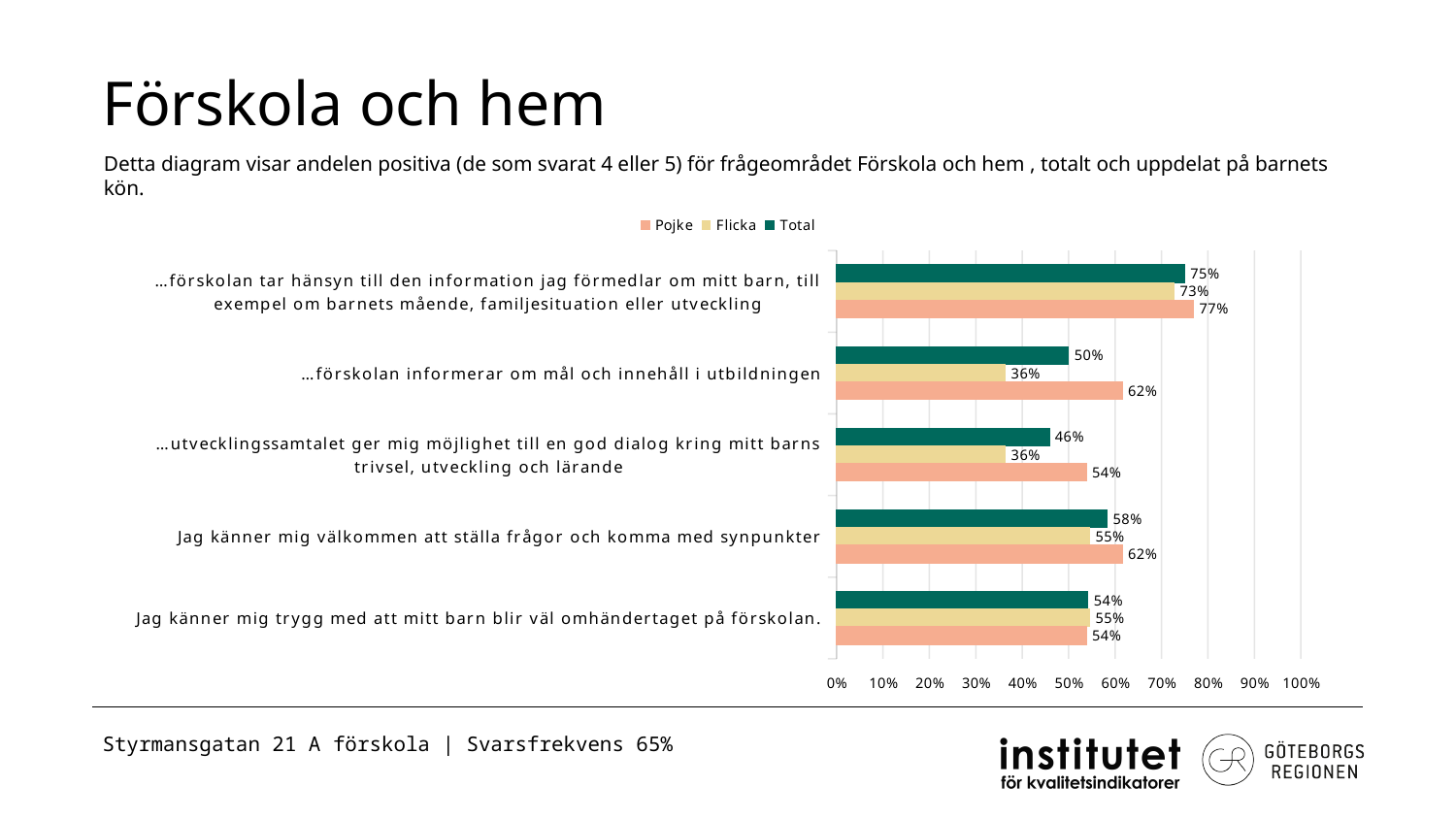
What is the Total value for "…förskolan informerar om mål och innehåll i utbildningen"? 50% Is the Total value for "Jag känner mig trygg med att mitt barn blir väl omhändertaget på förskolan." greater or less than 50%? greater What are the three series listed in the legend? Pojke, Flicka, Total What kind of chart is shown on the slide? Bar chart How many statements (categories) are shown in the chart? 5 How many series does the legend list? 3 Which statement has the highest Total value? …förskolan tar hänsyn till den information jag förmedlar om mitt barn, till exempel om barnets mående, familjesituation eller utveckling For "…utvecklingssamtalet ger mig möjlighet till en god dialog kring mitt barns trivsel, utveckling och lärande", which is larger, the Pojke value or the Flicka value? Pojke Which statement has the lowest Total value? …utvecklingssamtalet ger mig möjlighet till en god dialog kring mitt barns trivsel, utveckling och lärande What is the Flicka value for "Jag känner mig välkommen att ställa frågor och komma med synpunkter"? 55% What is the Pojke value for "…förskolan tar hänsyn till den information jag förmedlar om mitt barn, till exempel om barnets mående, familjesituation eller utveckling"? 77% What is the difference between the Pojke and Flicka values for "…förskolan informerar om mål och innehåll i utbildningen"? 26 percentage points